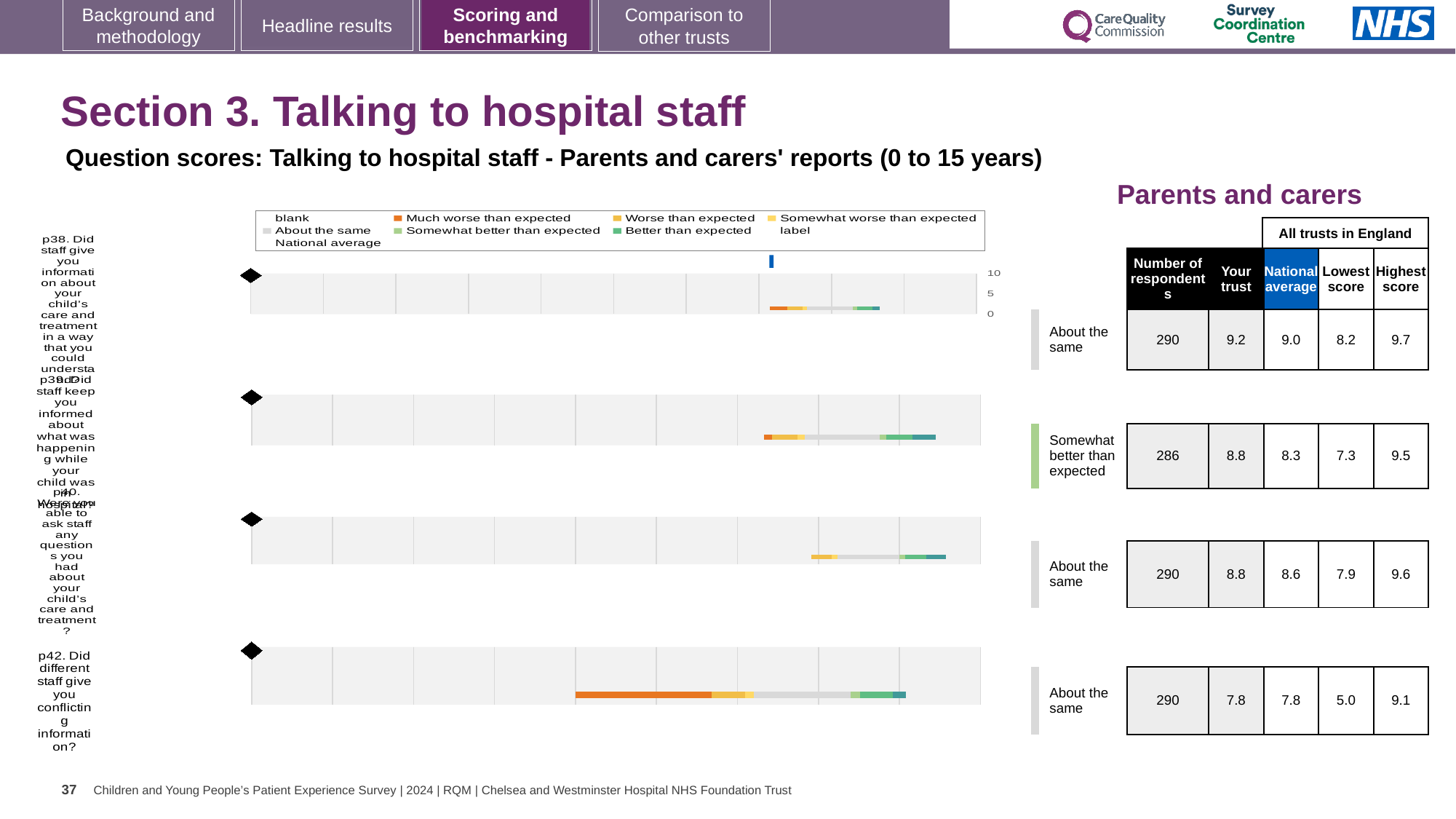
What kind of chart is used to show the question scores on this slide? bar chart How many questions (p38, p39, p40, p42) are plotted as separate bars on the slide? 4 How many respondents answered question p39? 286 For question p38 (Did staff give you information about your child's care and treatment in a way that you could understand?), what is the 'Your trust' score? 9.2 In the legend, which colour represents 'Much worse than expected'? orange What benchmark category is shown for question p39? Somewhat better than expected For question p39, which is larger: the 'Your trust' score or the national average? Your trust Which question has the lowest 'Your trust' score? p42 For question p39 (Did staff keep you informed about what was happening while your child was in hospital?), what is the national average score? 8.3 Which question has the highest 'Your trust' score? p38 For question p38, what is the difference between the 'Your trust' score and the national average? 0.2 For question p42 (Did different staff give you conflicting information?), what is the lowest score among all trusts in England? 5.0